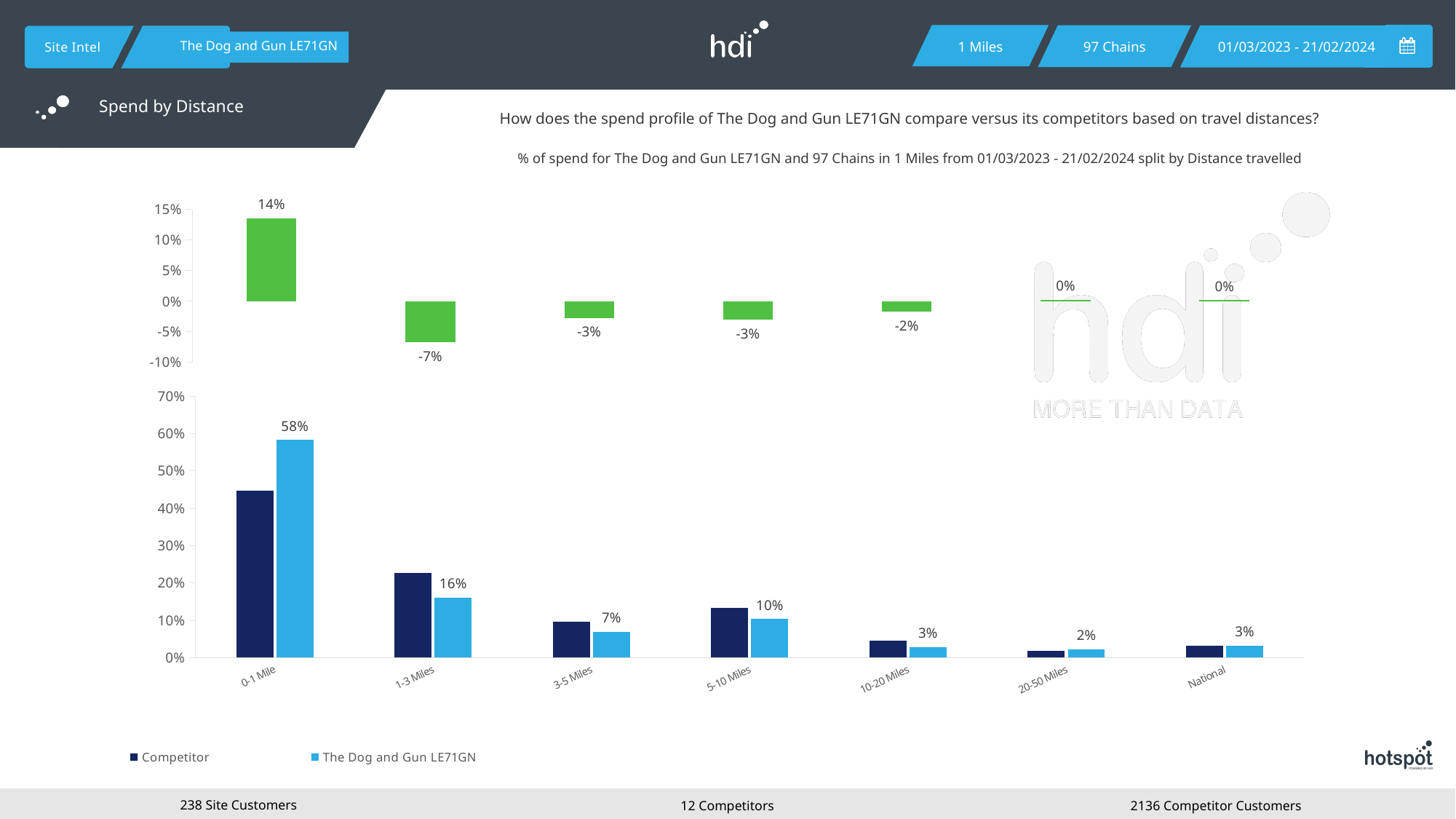
In the bottom chart, which distance band has the highest value for The Dog and Gun LE71GN? 0-1 Mile How many distance categories are shown on the x axis of the bottom chart? 7 In the bottom chart, is the Competitor value at 0-1 Mile greater or less than 40%? greater How many series does the legend of the bottom chart list? 2 In the bottom chart, what is the value for The Dog and Gun LE71GN at 5-10 Miles? 10% In the bottom chart, what is the difference between The Dog and Gun LE71GN values at 0-1 Mile and 1-3 Miles? 42 percentage points What kind of chart is the bottom chart? bar chart In the bottom chart, what is the value for The Dog and Gun LE71GN at 0-1 Mile? 58% In the bottom chart, at 1-3 Miles, which is larger: Competitor or The Dog and Gun LE71GN? Competitor In the top chart, what is the lowest value shown? -7% In the top chart, what is the value of the first (leftmost) bar? 14% In the bottom chart, what is the value for The Dog and Gun LE71GN at 20-50 Miles? 2%